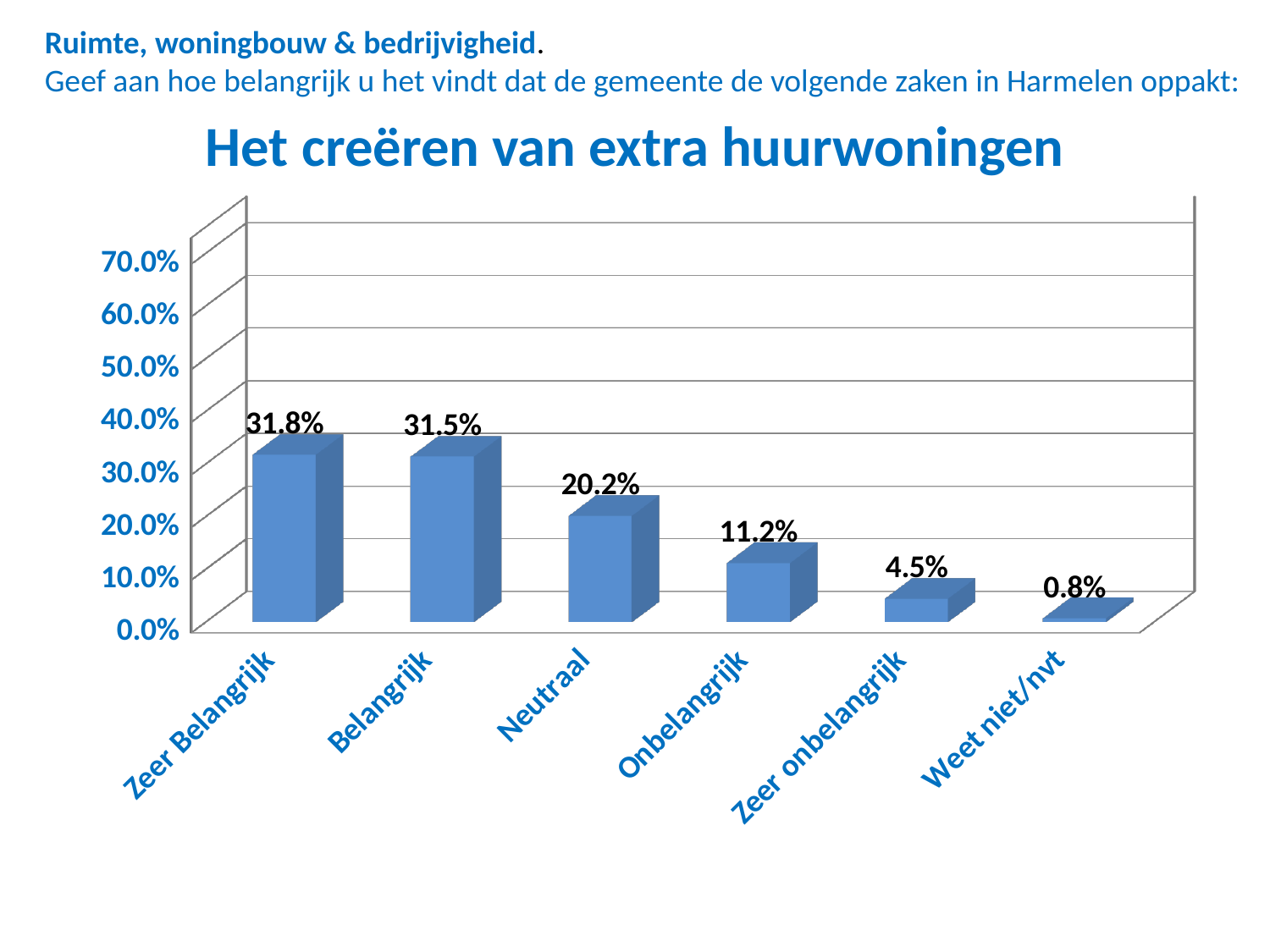
What is the title of the chart? Het creëren van extra huurwoningen Which category has the highest value? Zeer Belangrijk What is the value for Zeer onbelangrijk? 4.5% What is the difference between the values for Neutraal and Onbelangrijk? 9.0% How many categories are shown on the x axis? 6 What kind of chart is shown on the slide? Bar chart What is the value for Zeer Belangrijk? 31.8% Which is larger, the value for Belangrijk or the value for Neutraal? Belangrijk What is the value for Weet niet/nvt? 0.8% What is the value for Neutraal? 20.2% Do the values rise or fall from left to right along the x axis? Fall Which category has the lowest value? Weet niet/nvt